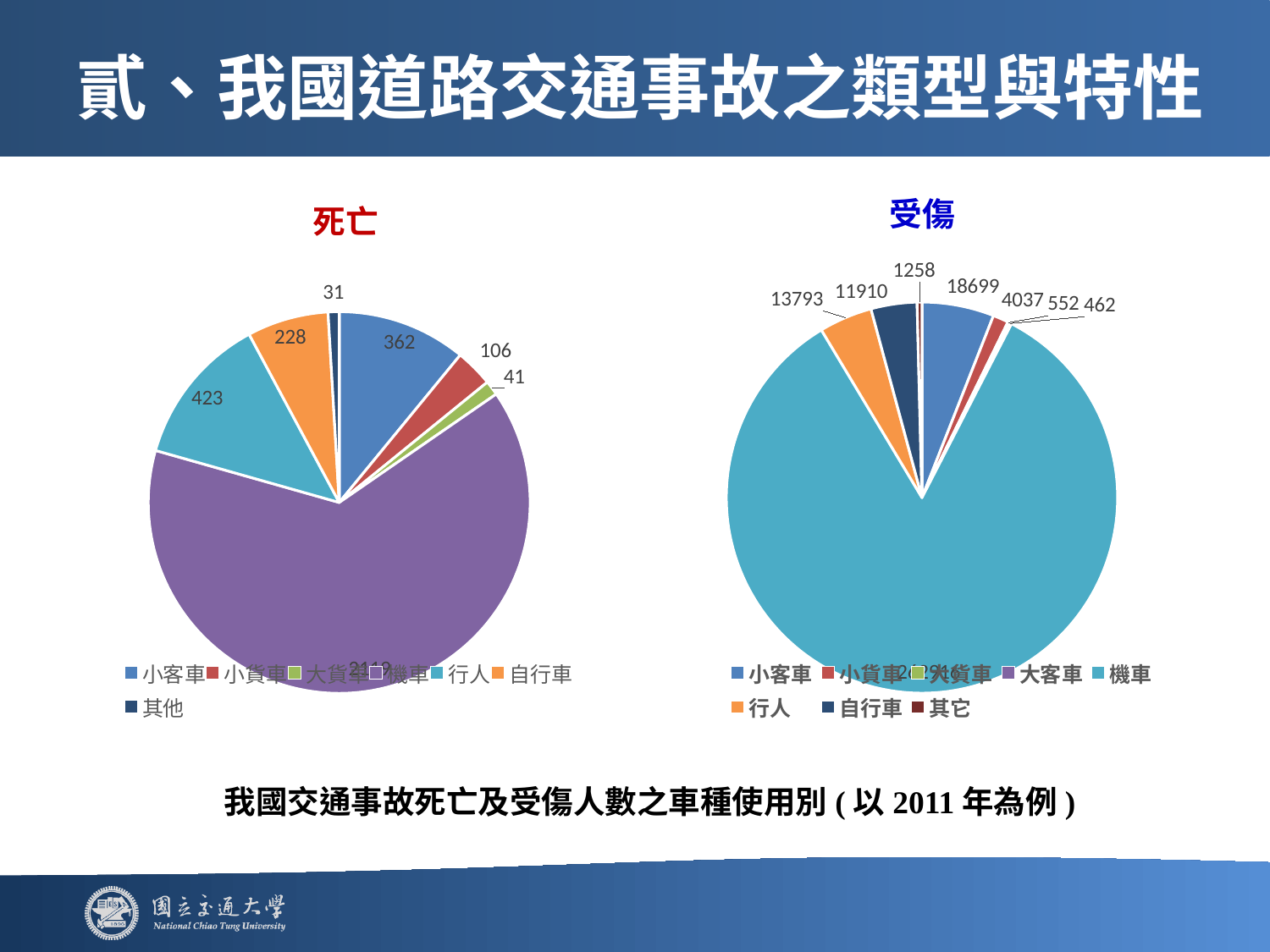
In the 死亡 chart, what is the value for 行人? 423 In the 受傷 chart, which category has the largest slice? 機車 In the 死亡 chart, which category has the largest slice? 機車 In the 死亡 chart, what is the value for 小客車? 362 In the 受傷 chart, what is the value for 小客車? 18699 In the 死亡 chart, what is the value for 自行車? 228 In the 死亡 chart, what is the difference between the values for 行人 and 小客車? 61 In the 受傷 chart, which is larger, the value for 行人 or the value for 自行車? 行人 In the 死亡 chart, which category has the smallest slice? 其他 What kind of charts are shown on the slide? Pie charts How many categories does the legend of the 受傷 chart list? 8 In the 受傷 chart, what is the value for 行人? 13793